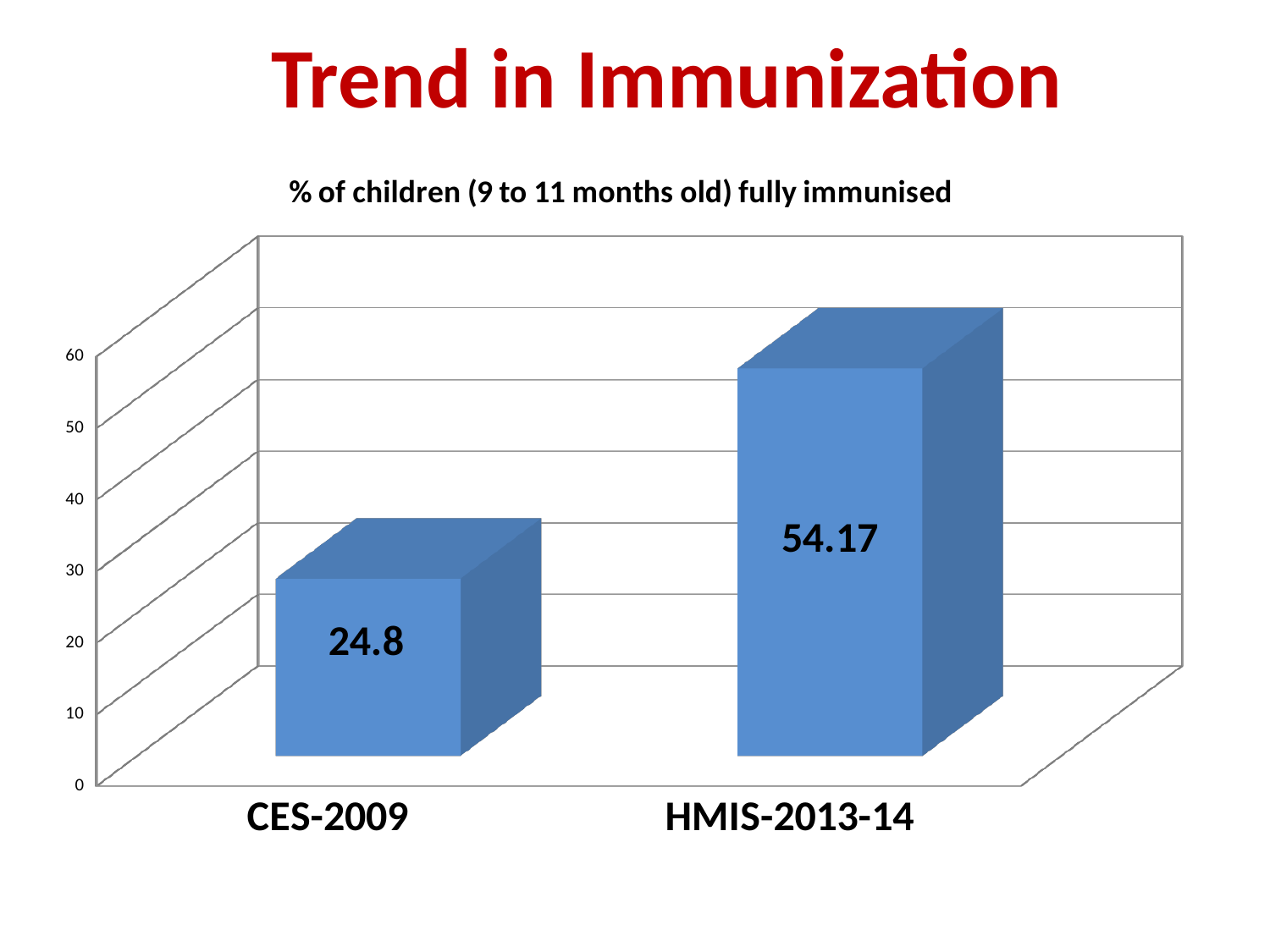
What is the title of the chart? % of children (9 to 11 months old) fully immunised What kind of chart is shown on the slide? bar chart Which category has the highest value? HMIS-2013-14 Which category has the lowest value? CES-2009 Which is larger, the value for CES-2009 or the value for HMIS-2013-14? HMIS-2013-14 Is the value for CES-2009 greater or less than 30? less Do the values rise or fall from CES-2009 to HMIS-2013-14? rise What is the difference between the values for HMIS-2013-14 and CES-2009? 29.37 How many categories are shown on the chart? 2 What is the value for CES-2009? 24.8 Is the value for HMIS-2013-14 greater or less than 50? greater What is the value for HMIS-2013-14? 54.17